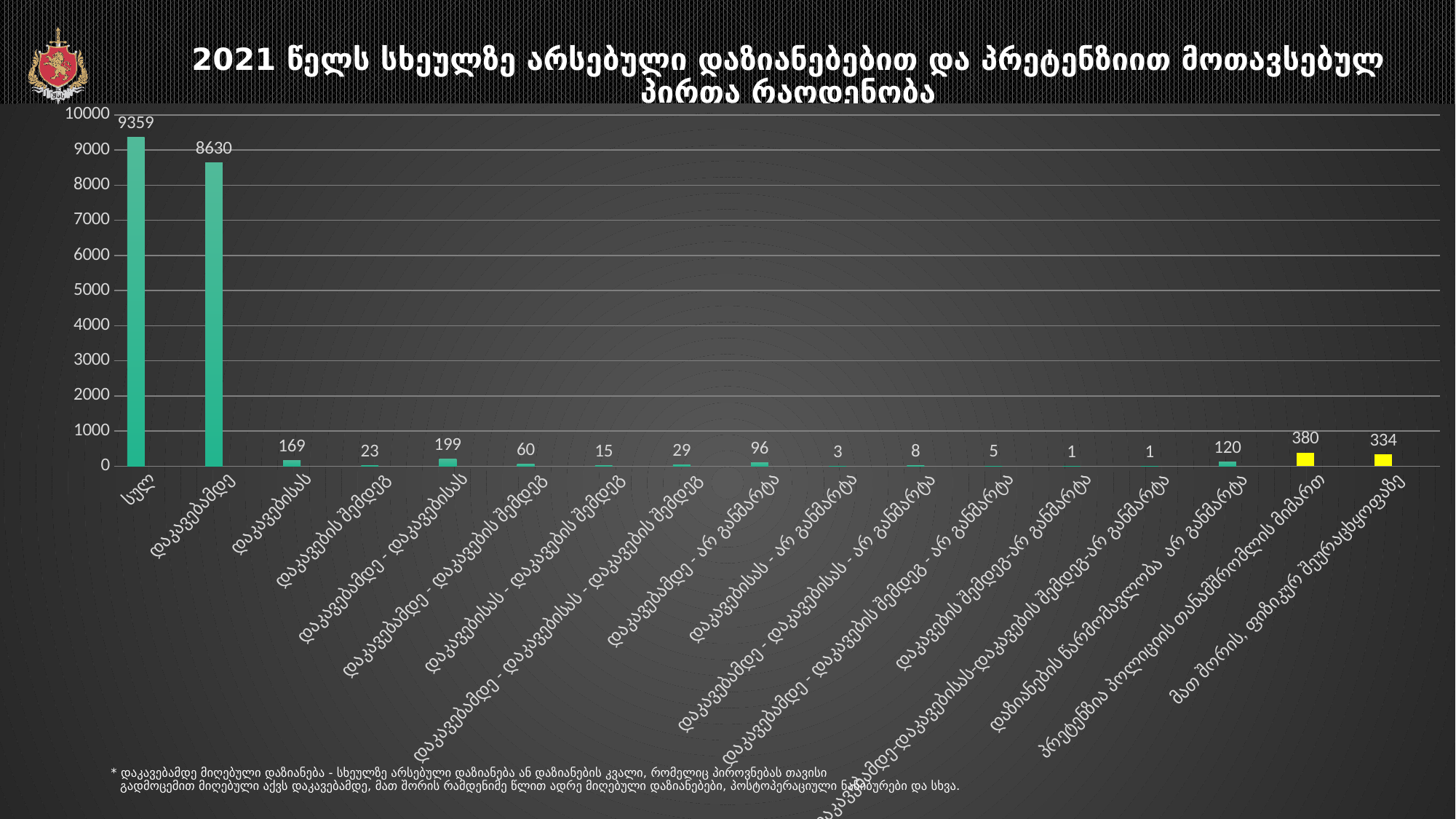
What is the value for სულ? 9359 What is the value for მათ შორის, ფიზიკურ შეურაცხყოფაზე? 334 Is the value for დაკავებამდე greater or less than 8000? greater What is the value for პრეტენზია პოლიციის თანამშრომლის მიმართ? 380 What is the value for დაკავებამდე? 8630 What colour are the two rightmost bars? yellow How many categories are shown on the x axis? 17 What is the value for დაკავებისას? 169 Which is larger, the value for დაკავებისას or the value for დაკავების შემდეგ? დაკავებისას What is the difference between the values for სულ and დაკავებამდე? 729 Which category has the highest value? სულ What kind of chart is shown on the slide? bar chart